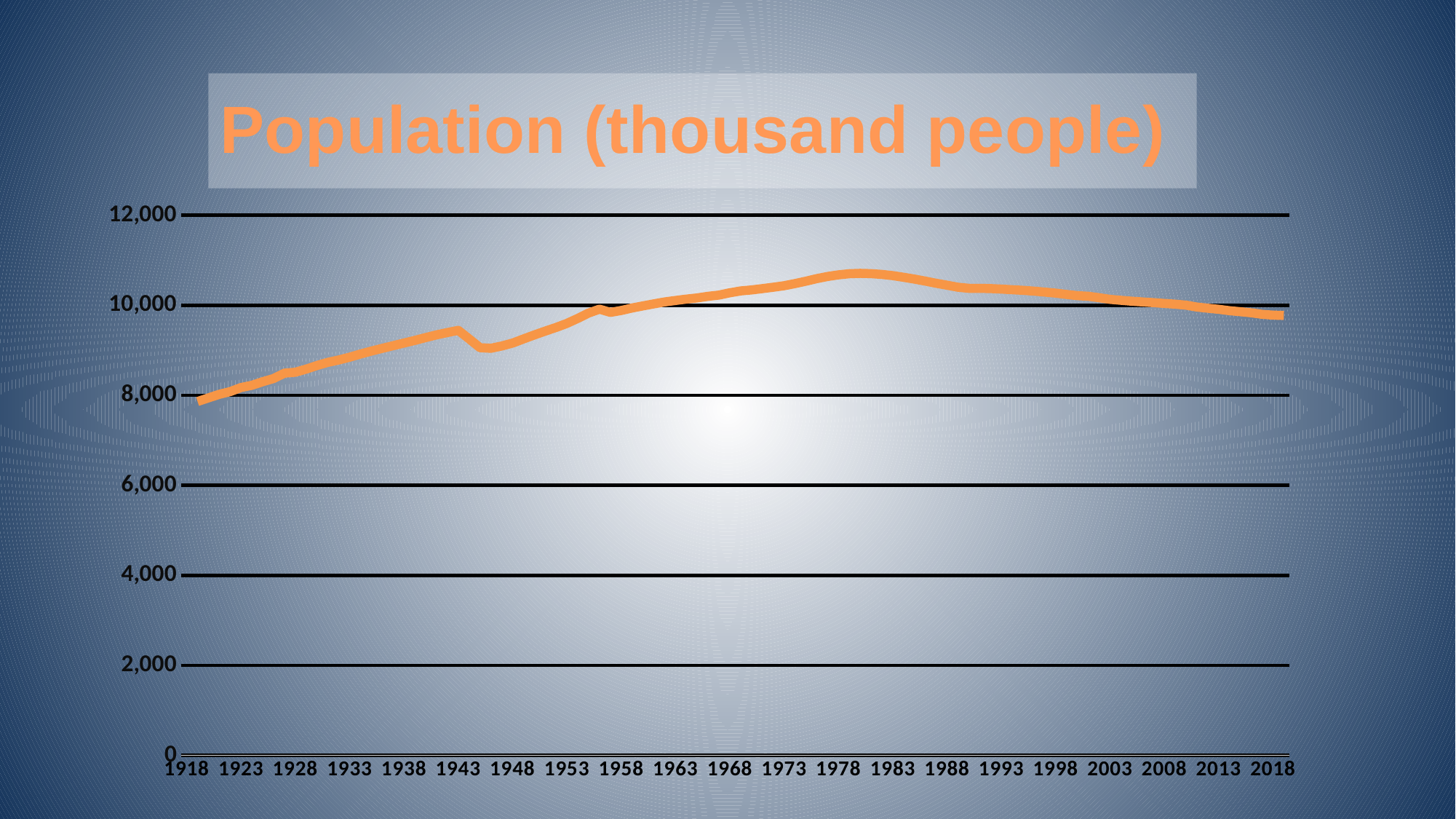
What kind of chart is shown on the slide? line chart Does the population rise or fall between 1918 and 1943? rise Which is larger, the value for 1978 or the value for 2018? 1978 Is the value for 1978 greater or less than 10,000? greater Is the value for 1928 greater or less than 8,000? greater Is the value for 1943 greater or less than 8,000? greater What is the title of the chart? Population (thousand people) Does the population rise or fall between 1983 and 2018? fall How many year labels are shown on the x axis? 21